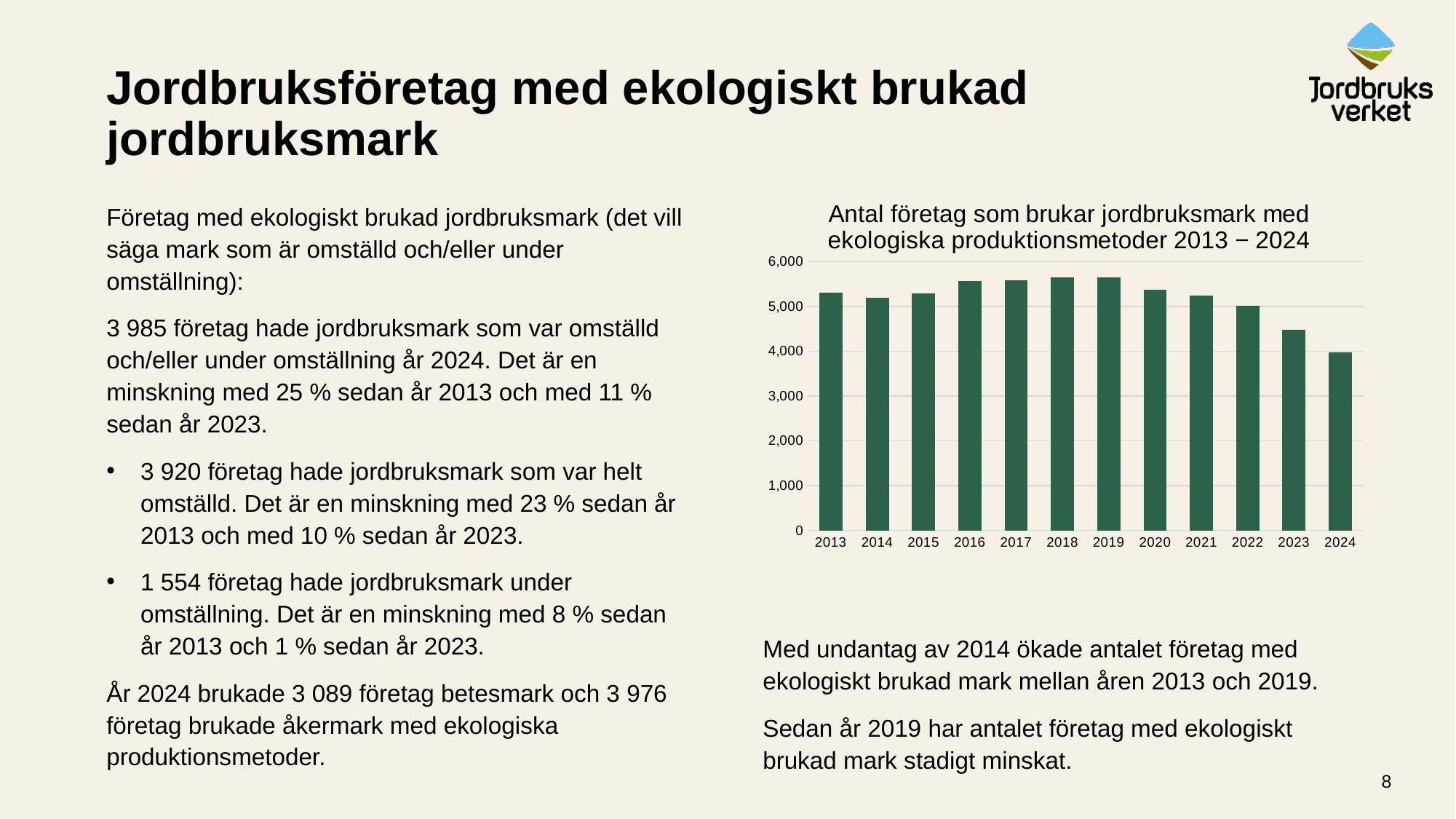
Is the value for 2018 greater or less than 5,000? greater Is the value for 2023 greater or less than 5,000? less Is the value for 2014 greater or less than 5,000? greater Which year has the larger value, 2014 or 2016? 2016 Which year has the lowest value in the chart? 2024 What is the title of the chart? Antal företag som brukar jordbruksmark med ekologiska produktionsmetoder 2013 − 2024 Do the values rise or fall from 2019 to 2024? fall How many years are shown on the x axis of the chart? 12 Which year has the larger value, 2013 or 2024? 2013 What kind of chart is shown on the slide? Bar chart